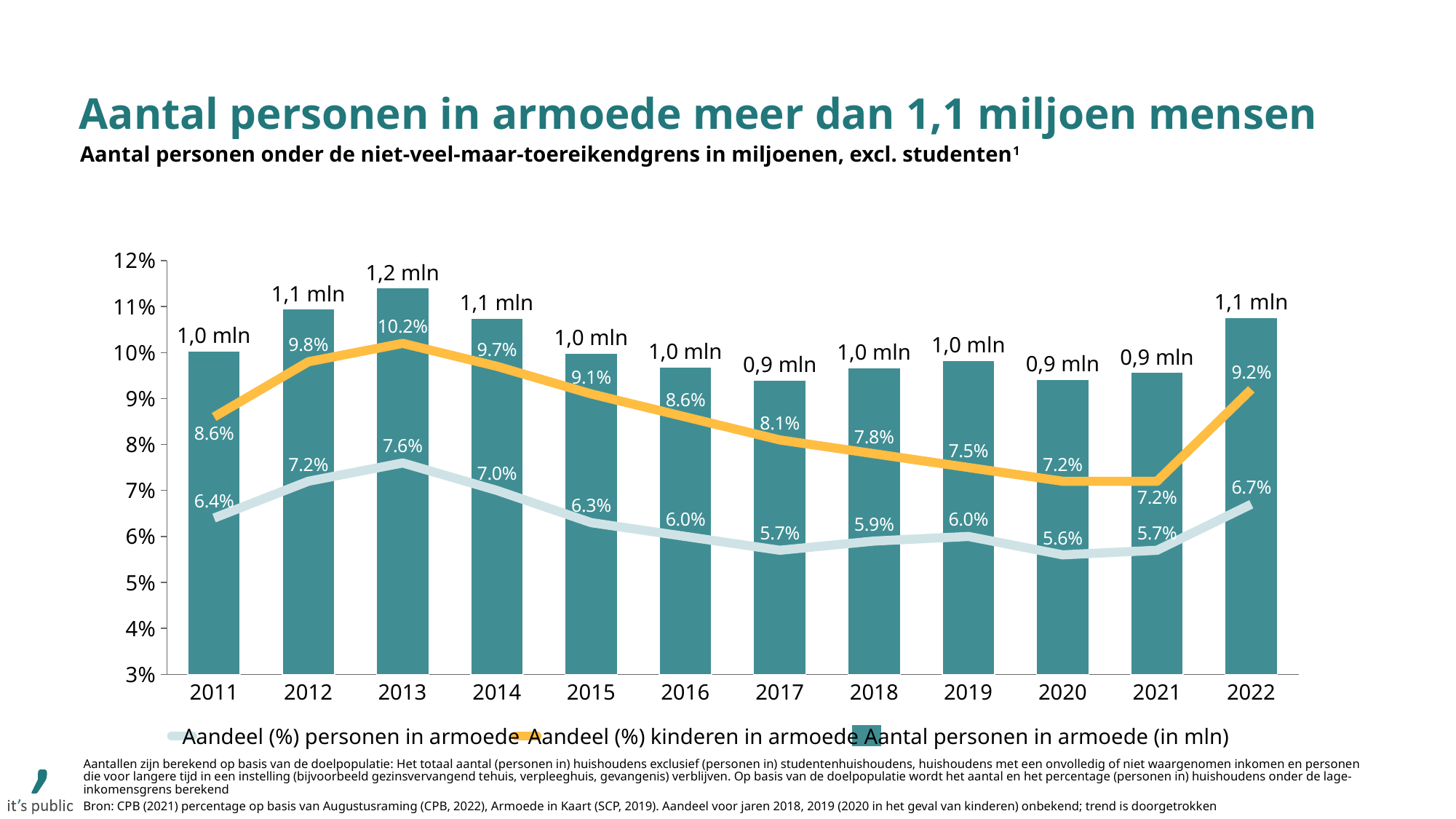
Which is larger: the share (%) of children in poverty in 2012 or in 2022? 2012 What is the share (%) of persons in poverty (Aandeel (%) personen in armoede) in 2020? 5.6% What is the difference between the share of children in poverty and the share of persons in poverty in 2022? 2.5% In which year is the share (%) of persons in poverty the lowest? 2020 What is the number of persons in poverty (Aantal personen in armoede) in 2013? 1,2 mln What colour is the line for Aandeel (%) kinderen in armoede? Orange What is the share (%) of children in poverty (Aandeel (%) kinderen in armoede) in 2013? 10.2% How many years are shown on the x axis? 12 In which year is the share (%) of children in poverty the highest? 2013 Does the share (%) of persons in poverty rise or fall from 2013 to 2017? Fall How many series does the legend list? 3 What kind of chart is shown on the slide? Combined bar and line chart